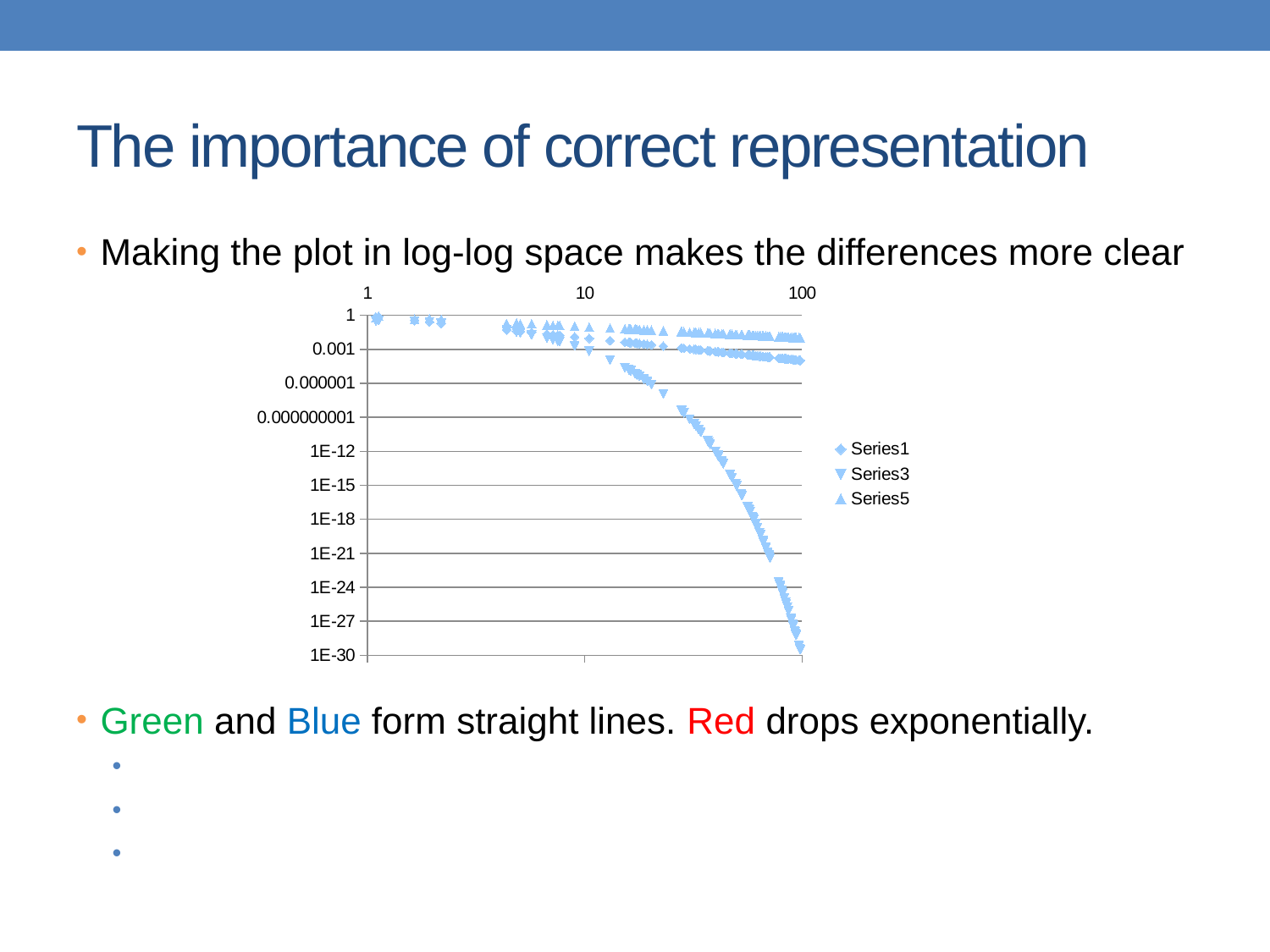
Is the value for Series3 near x = 100 greater or less than 1E-21? less How many series does the legend list? 3 What is the lowest tick label shown on the y axis? 1E-30 Do the plotted values rise or fall as x increases along the x axis? fall Which series are listed in the legend? Series1, Series3, Series5 What kind of chart is shown on the slide? scatter chart What is the highest tick label shown on the x axis? 100 Is the value for Series5 near x = 100 greater or less than 0.001? greater Which series drops most steeply as x approaches 100? Series3 Which series has the higher values near x = 100, Series1 or Series3? Series1 Is the value for Series1 near x = 100 greater or less than 0.000001? greater